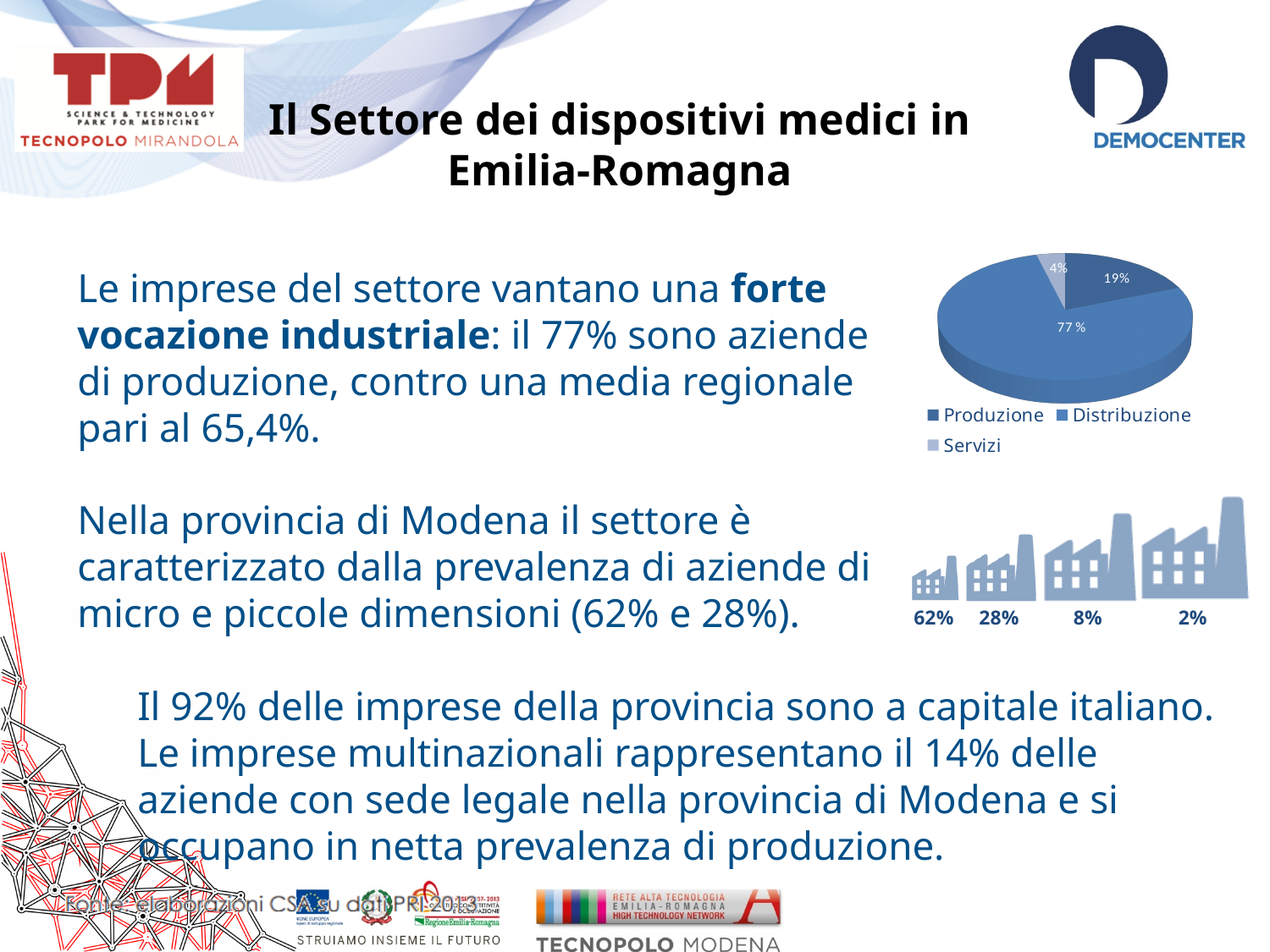
In the pie chart legend, which category is listed first? Produzione In the pie chart, which slice is larger: Distribuzione or Servizi? Distribuzione In the pie chart, what share is shown for Servizi? 4% Which category has the largest slice in the pie chart? Produzione Which category has the smallest slice in the pie chart? Servizi What kind of chart is shown on the right of the slide, next to the first paragraph? pie chart In the pie chart, what share is shown for Produzione? 77 % In the factory-icon graphic below the pie chart, what percentage is shown under the smallest factory icon? 62% How many entries does the legend of the pie chart list? 3 In the pie chart, what is the difference in percentage points between Produzione and Distribuzione? 58 How many slices does the pie chart have? 3 In the pie chart, what share is shown for Distribuzione? 19%